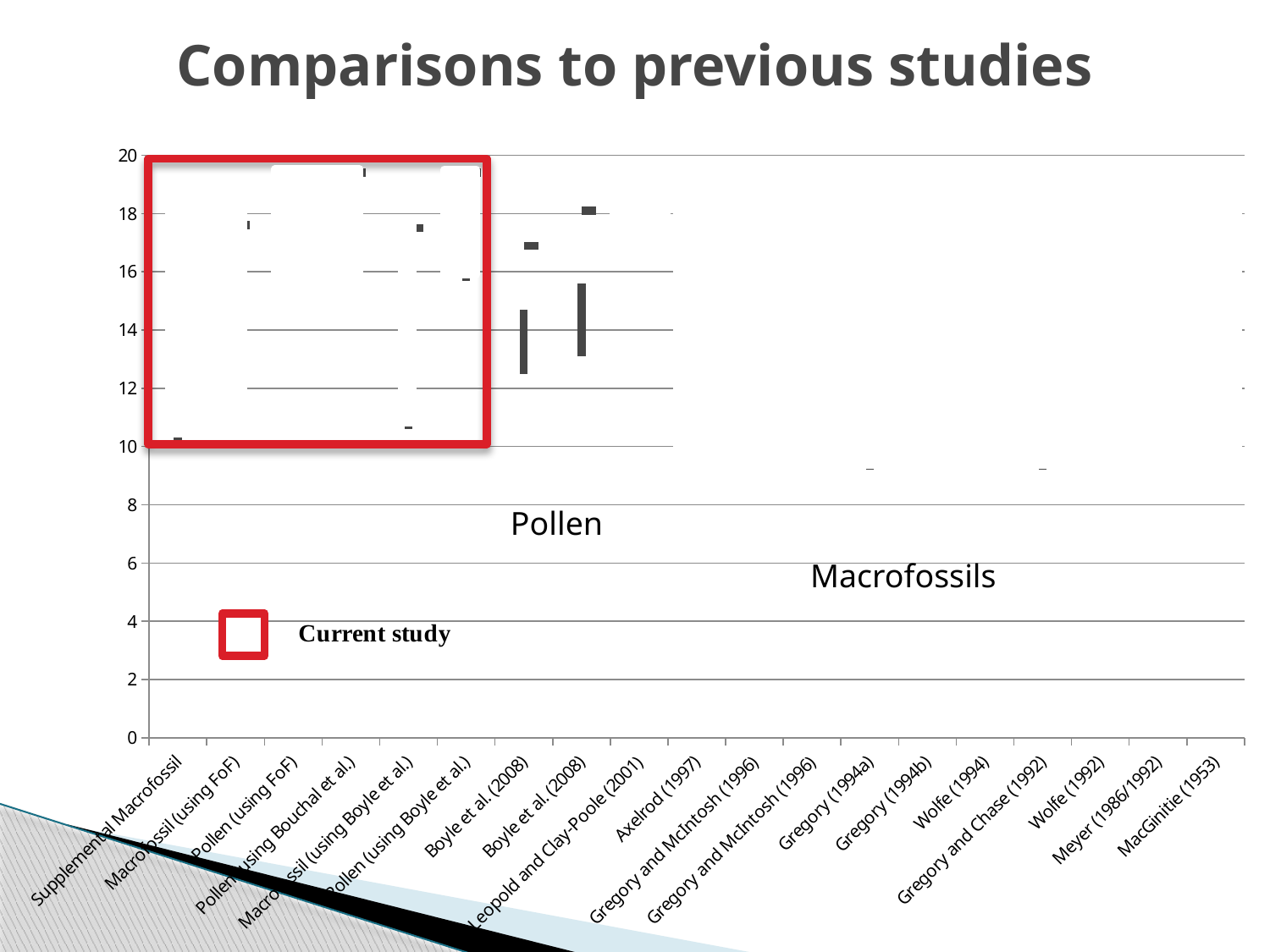
How many categories are listed along the x axis of the chart? 19 What is the last category on the x axis of the chart? MacGinitie (1953) Is the lowest point of the leftmost Boyle et al. (2008) bar greater or less than 12? greater What label does the red box in the legend area of the chart carry? Current study What kind of chart is shown on the slide? bar chart What is the highest value shown on the y axis of the chart? 20